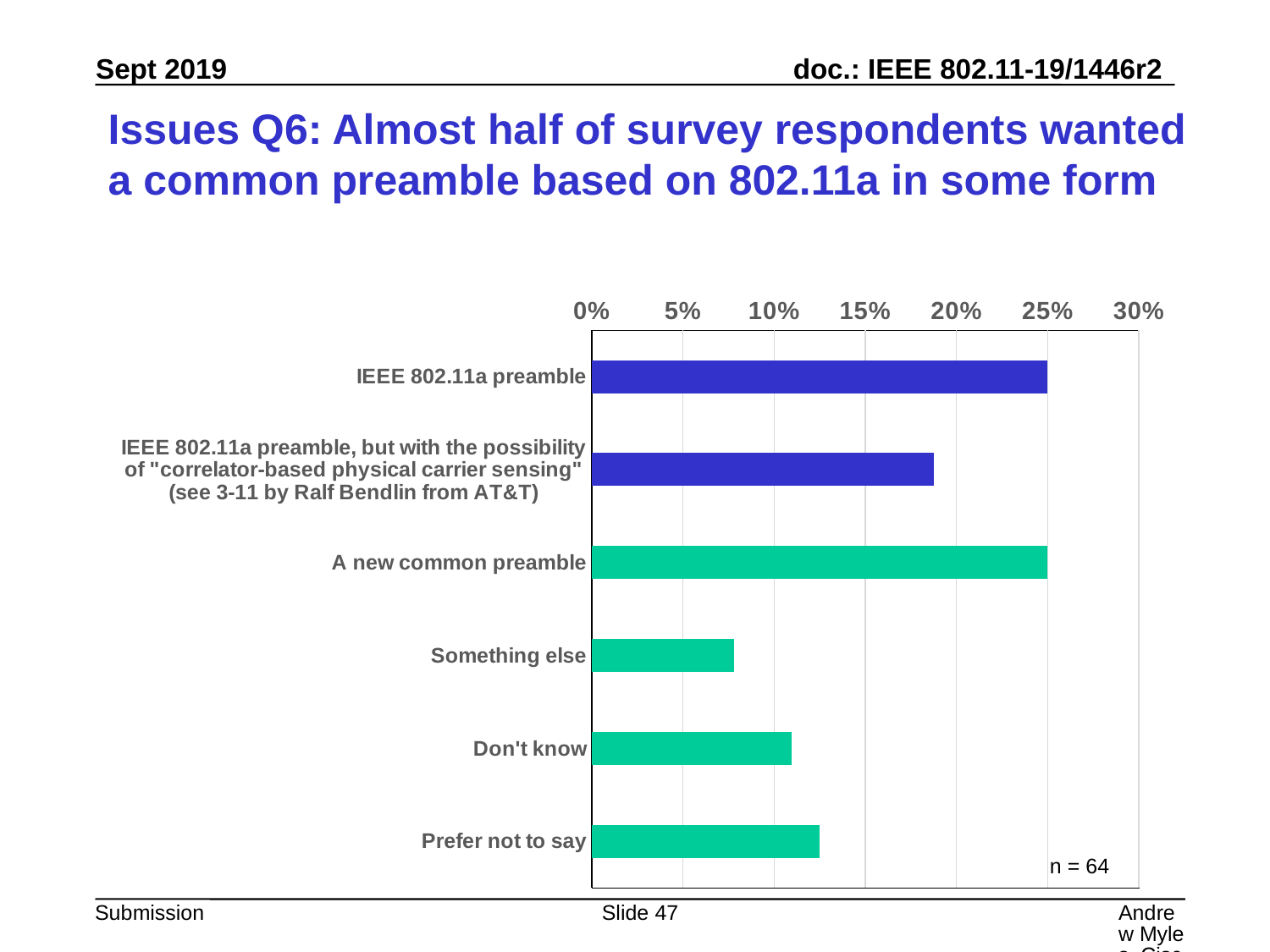
What kind of chart is shown on the slide? bar chart What sample size (n) is noted on the chart? n = 64 Is the value for "Something else" greater or less than 10%? less What is the value for "A new common preamble"? 25% Is the value for "IEEE 802.11a preamble, but with the possibility of 'correlator-based physical carrier sensing'" greater or less than 20%? less Is the value for "Don't know" greater or less than 10%? greater How many categories are shown in the chart? 6 Which is larger, the value for "Prefer not to say" or the value for "IEEE 802.11a preamble, but with the possibility of 'correlator-based physical carrier sensing'"? IEEE 802.11a preamble, but with the possibility of "correlator-based physical carrier sensing" Which is larger, the value for "Something else" or the value for "Don't know"? Don't know What is the value for "IEEE 802.11a preamble"? 25% Which category has the lowest value in the chart? Something else